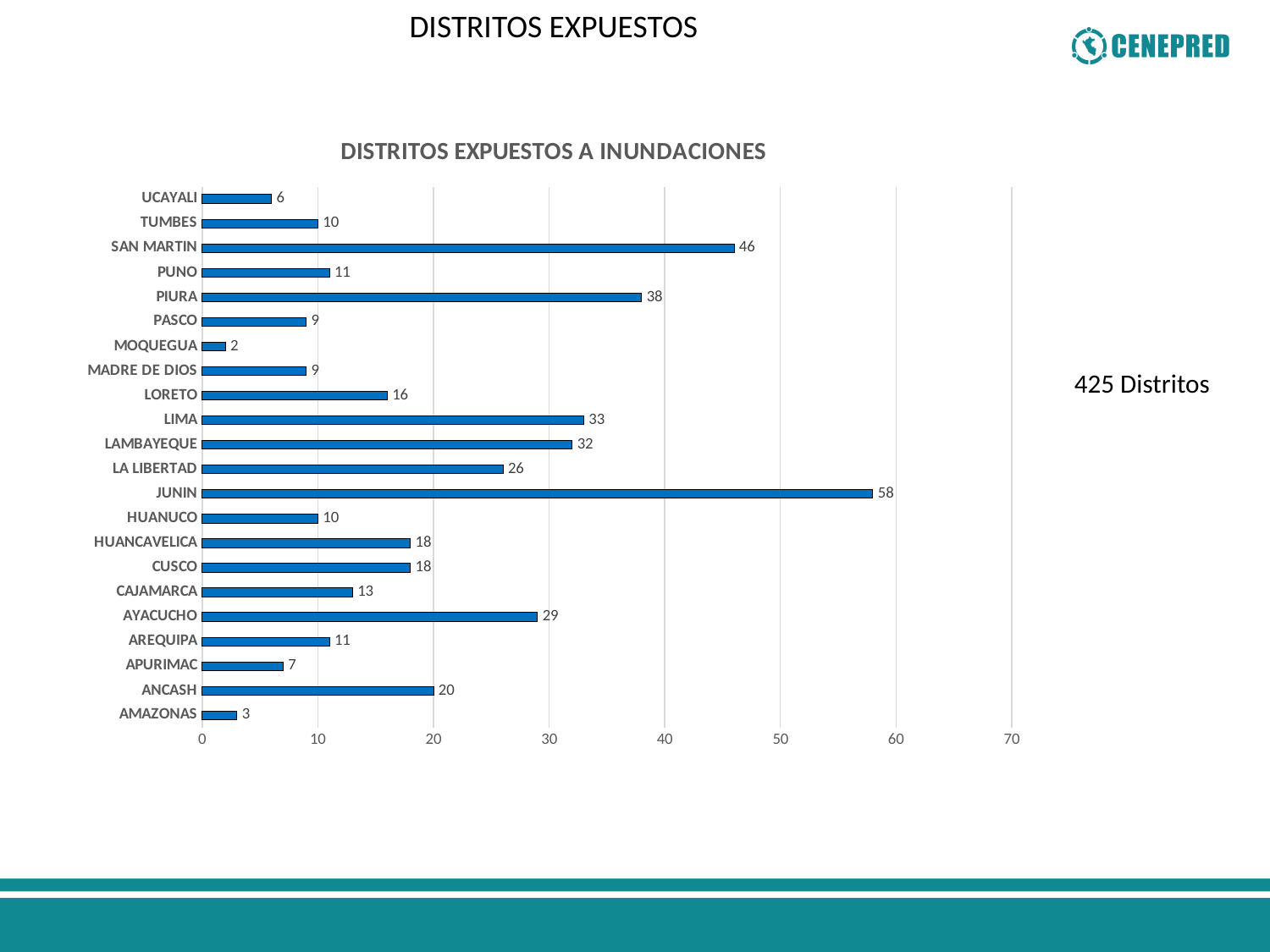
Which category has the highest value? JUNIN Which category has the lowest value? MOQUEGUA What is the value for PIURA? 38 Which is larger, the value for LIMA or the value for LAMBAYEQUE? LIMA Is the value for AYACUCHO greater or less than 20? greater What is the difference between the values for JUNIN and AMAZONAS? 55 What is the title of the chart? DISTRITOS EXPUESTOS A INUNDACIONES What is the value for MADRE DE DIOS? 9 What kind of chart is shown? bar chart How many categories are shown in the chart? 22 What is the difference between the values for SAN MARTIN and PIURA? 8 What is the value for JUNIN? 58